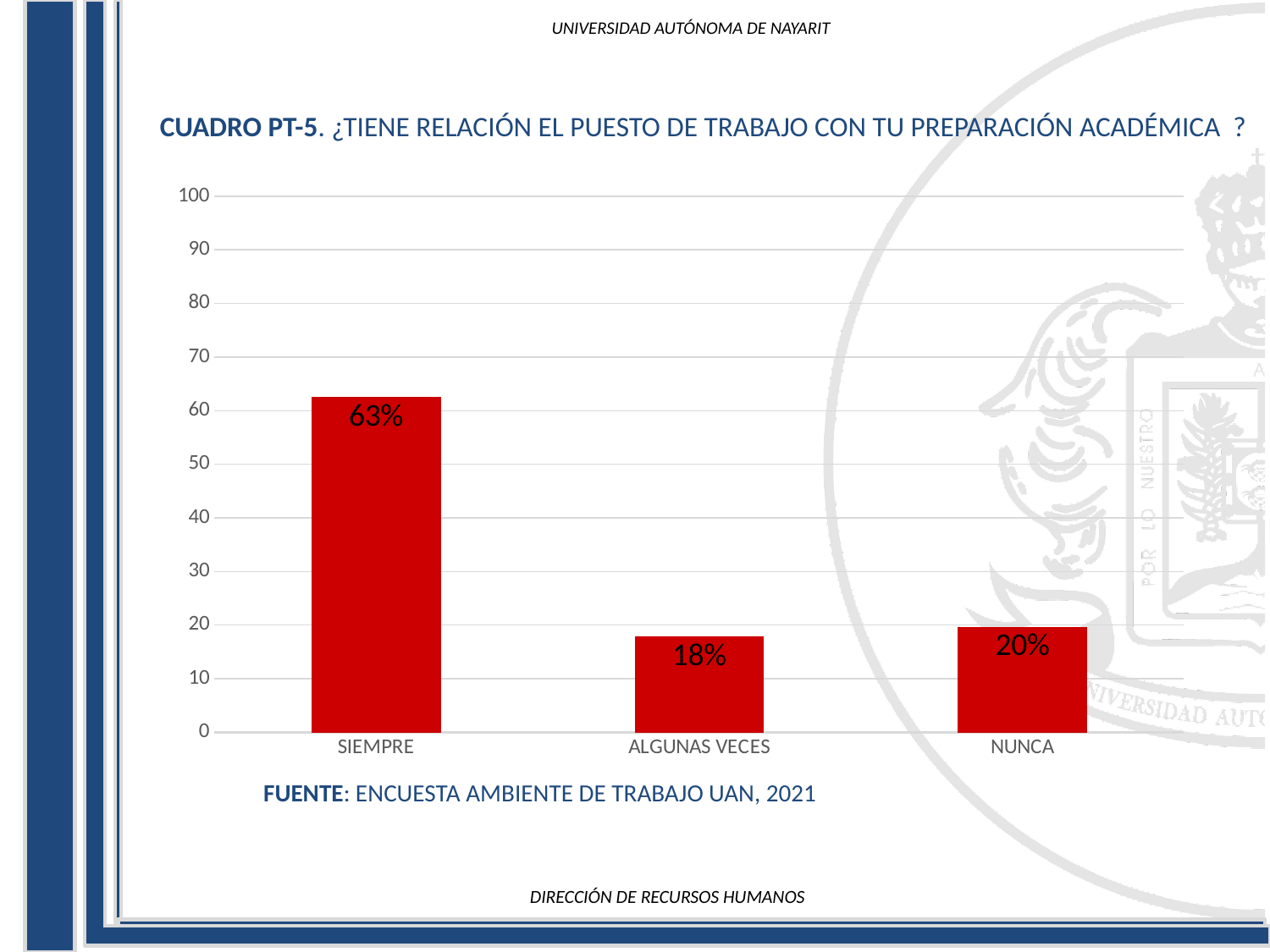
What kind of chart is shown on the slide? bar chart How many categories are shown on the x axis? 3 Which is larger, the value for SIEMPRE or the value for ALGUNAS VECES? SIEMPRE Which category has the highest value? SIEMPRE What is the value for ALGUNAS VECES? 18% What is the value for SIEMPRE? 63% What is the difference between the values for SIEMPRE and NUNCA? 43% What is the difference between the values for NUNCA and ALGUNAS VECES? 2% Which category has the lowest value? ALGUNAS VECES What source is cited below the chart? ENCUESTA AMBIENTE DE TRABAJO UAN, 2021 What is the value for NUNCA? 20% Is the value for SIEMPRE greater or less than 50? greater